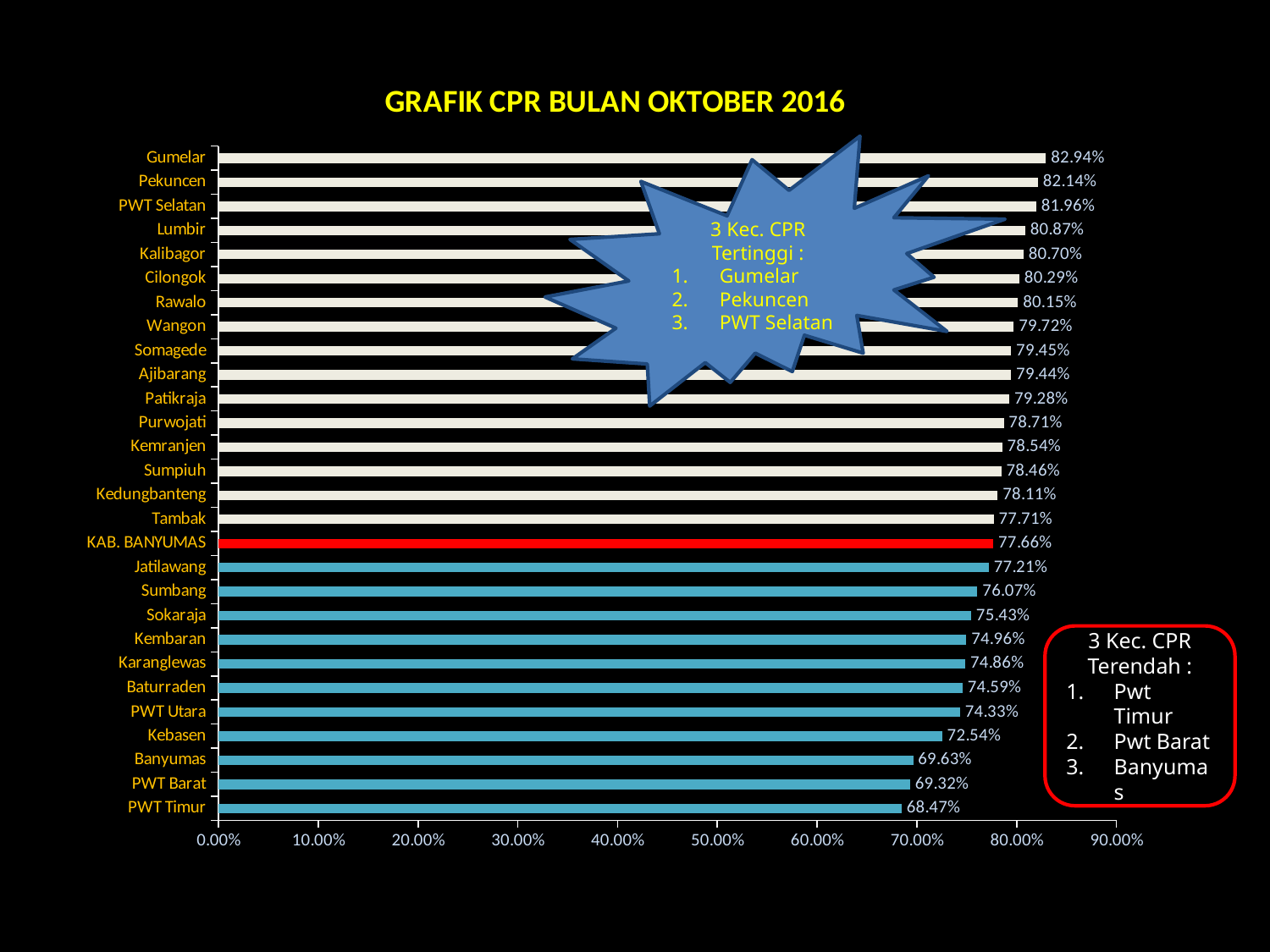
How many categories are plotted on the chart? 28 What is the CPR value for Gumelar? 82.94% Which category has the lowest CPR value? PWT Timur Which category has the highest CPR value? Gumelar What is the difference between the CPR values of Gumelar and PWT Timur? 14.47% What kind of chart is shown on the slide? bar chart What is the CPR value for KAB. BANYUMAS? 77.66% What is the title of the chart? GRAFIK CPR BULAN OKTOBER 2016 Which has a higher CPR value, Sumbang or Kembaran? Sumbang What is the CPR value for Kebasen? 72.54% What is the difference between the CPR values of KAB. BANYUMAS and Jatilawang? 0.45% Is the CPR value for Banyumas greater or less than 70.00%? less